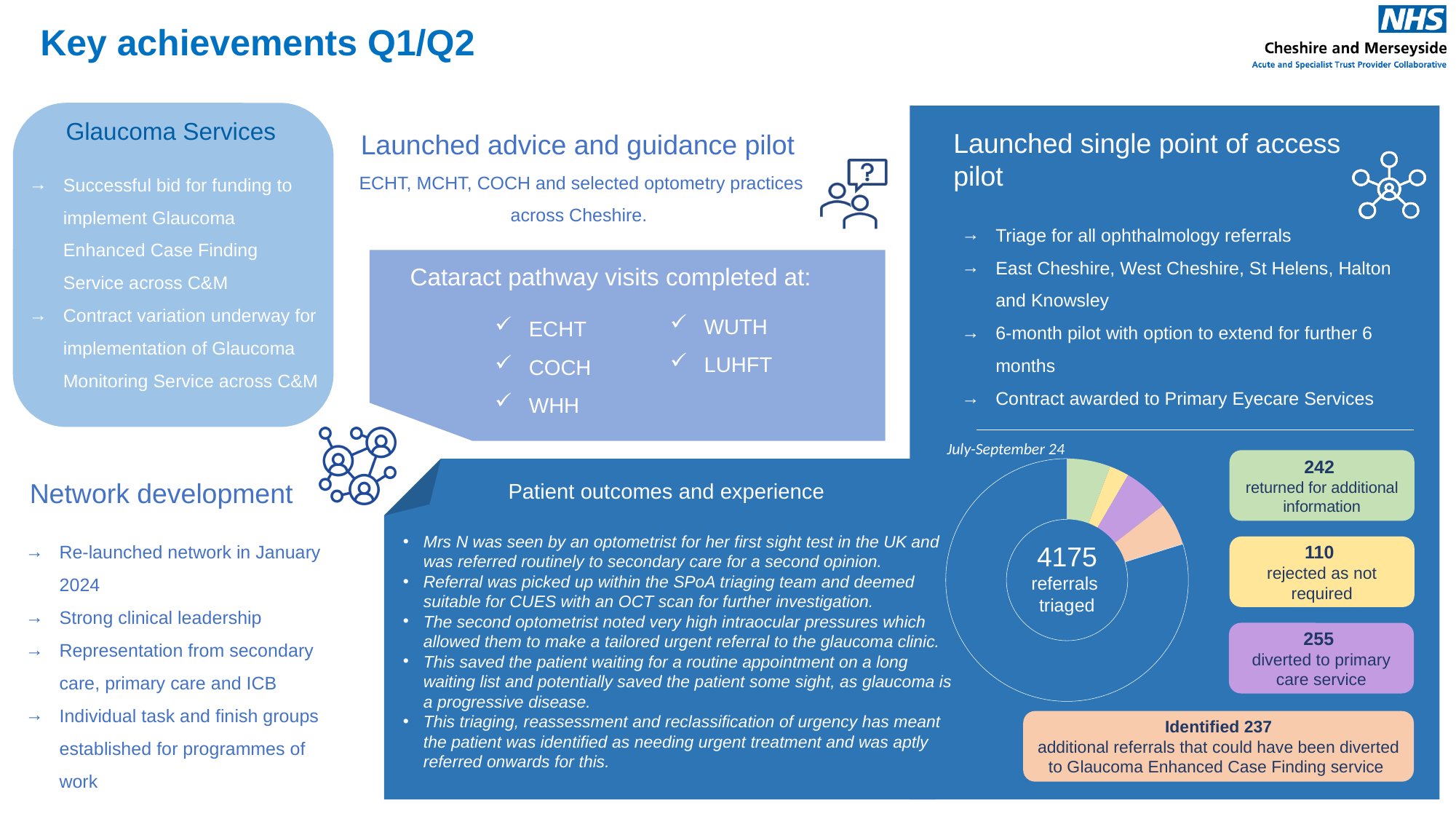
What is the difference between the number of referrals diverted to primary care service and the number rejected as not required? 145 How many referrals were triaged according to the centre of the doughnut chart? 4175 What colour is used for the 'diverted to primary care service' segment of the doughnut chart? Purple How many referrals were diverted to primary care service? 255 What kind of chart is shown in the bottom-right of the slide under 'July-September 24'? Doughnut (pie) chart How many additional referrals were identified that could have been diverted to the Glaucoma Enhanced Case Finding service? 237 What time period does the doughnut chart cover? July-September 24 How many referrals were rejected as not required? 110 Which is larger: the number of referrals returned for additional information or the number identified as additional referrals that could have been diverted to the Glaucoma Enhanced Case Finding service? returned for additional information How many referrals were returned for additional information? 242 Of the labelled outcomes beside the doughnut chart, which has the highest number of referrals? diverted to primary care service Of the labelled outcomes beside the doughnut chart, which has the lowest number of referrals? rejected as not required